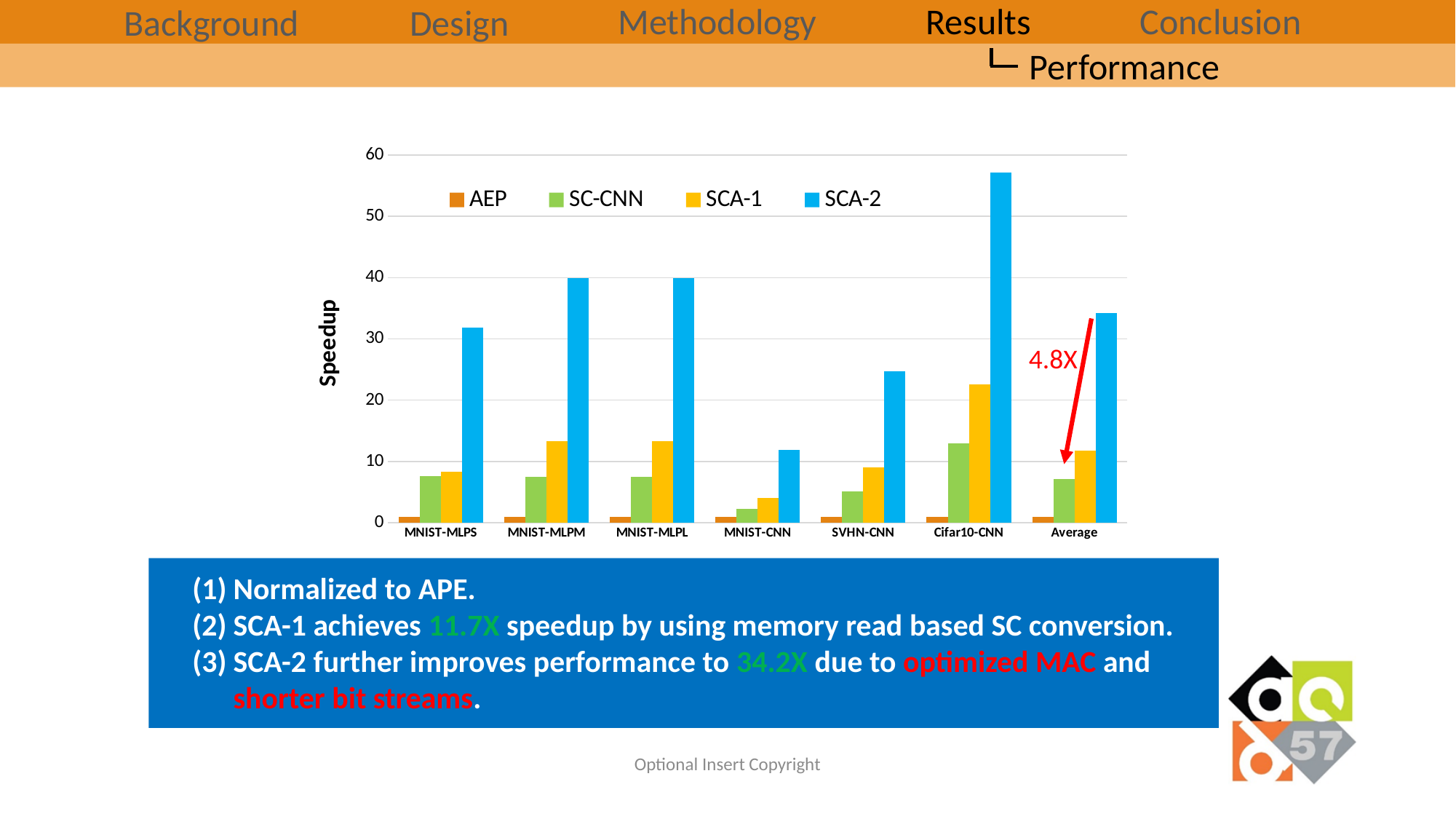
Is the SC-CNN value for MNIST-CNN greater or less than 10? less What type of chart is shown on the slide? bar chart What does the red annotation next to the Average bars say? 4.8X How many series does the chart legend list? 4 Does the SCA-1 bar rise or fall from MNIST-MLPS to MNIST-MLPM? rise Which category has the lowest SCA-2 bar? MNIST-CNN How many categories are shown along the x axis of the chart? 7 Is the SCA-2 value for MNIST-MLPS greater or less than 30? greater Which category has the highest SCA-2 bar? Cifar10-CNN Is the SCA-2 value for Cifar10-CNN greater or less than 50? greater What is the label on the y axis of the chart? Speedup For Cifar10-CNN, which is larger: the SCA-1 bar or the SC-CNN bar? SCA-1